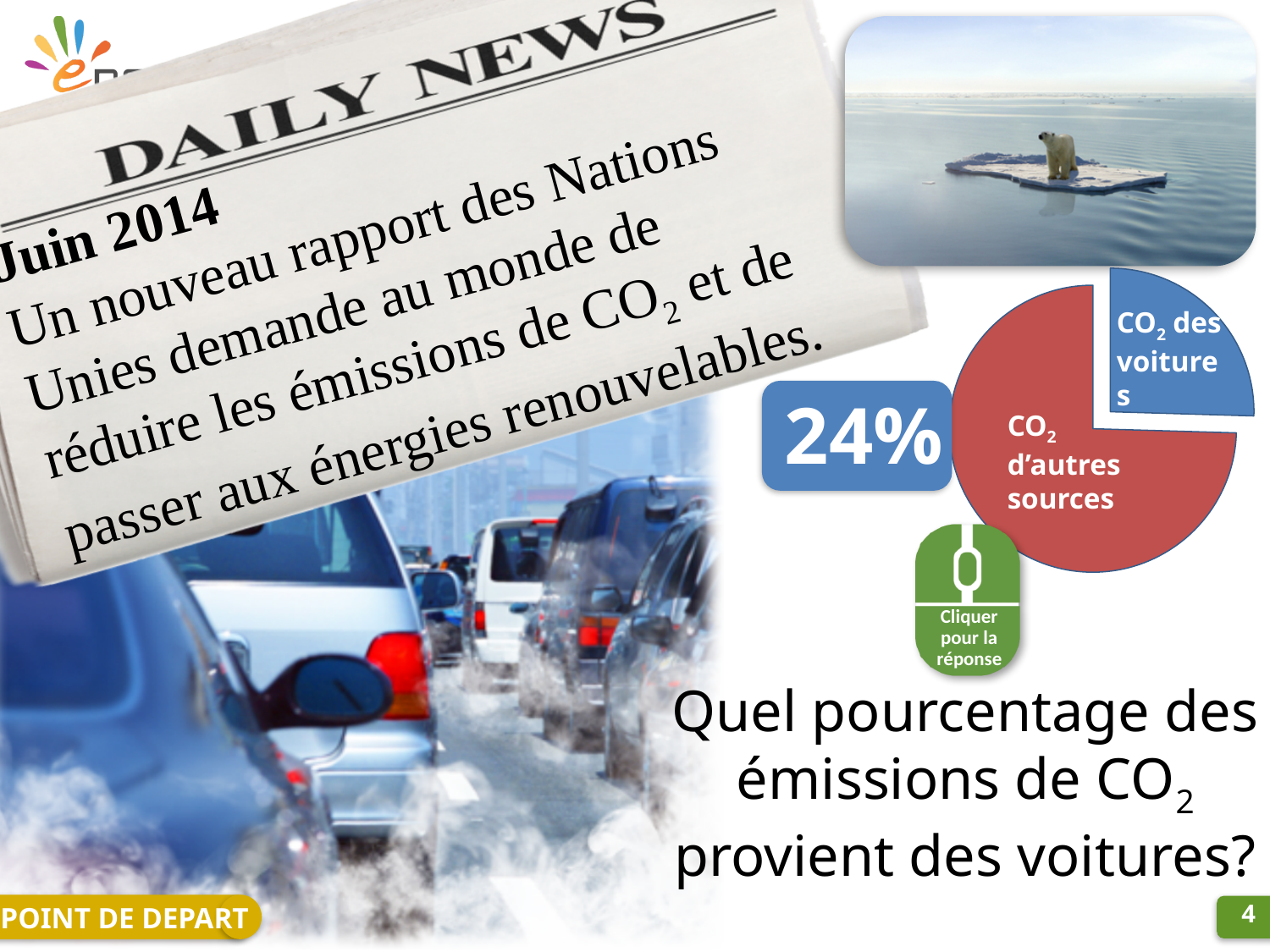
How many slices does the pie chart have? 2 Which slice of the pie chart is the smallest? CO2 des voitures What colour is the CO2 des voitures slice in the pie chart? blue Which slice of the pie chart is the largest? CO2 d'autres sources Which is larger in the pie chart: CO2 des voitures or CO2 d'autres sources? CO2 d'autres sources Which slice of the pie chart is pulled out (exploded) from the rest? CO2 des voitures What share of CO2 emissions comes from cars (CO2 des voitures) according to the slide? 24% What kind of chart is shown on the slide? pie chart